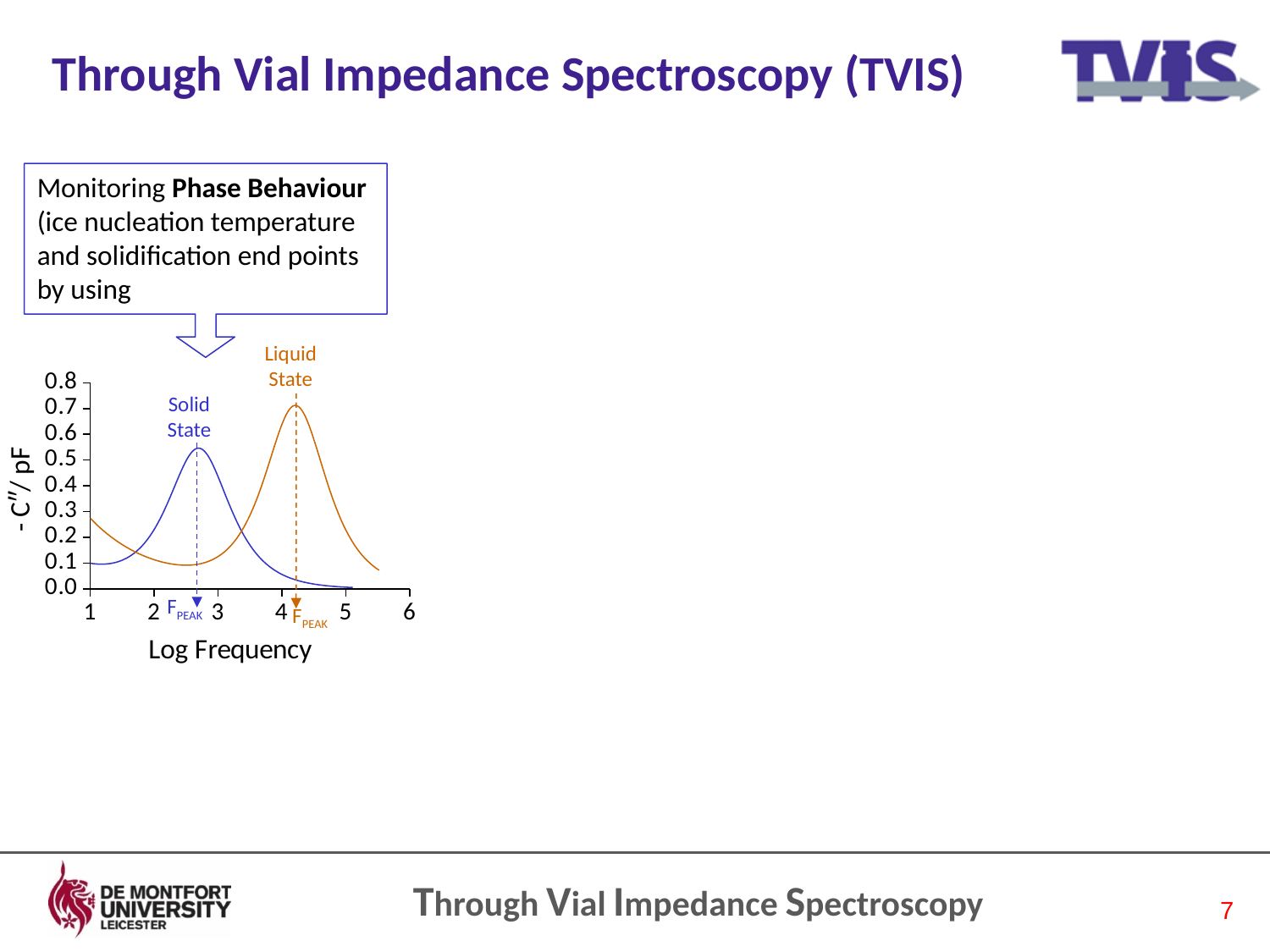
What kind of chart is shown on the slide? line chart What is the title of the x axis of the chart? Log Frequency What is the label on the y axis of the chart? - C''/ pF Which curve has its peak at the higher log frequency, Solid State or Liquid State? Liquid State Is the peak of the Solid State curve located at a log frequency greater or less than 2? greater Is the peak value of the Solid State curve greater or less than 0.7? less Is the peak value of the Liquid State curve greater or less than 0.6? greater How many curves are plotted on the chart? 2 What is the highest value shown on the y axis of the chart? 0.8 Which curve reaches the higher peak value, Solid State or Liquid State? Liquid State